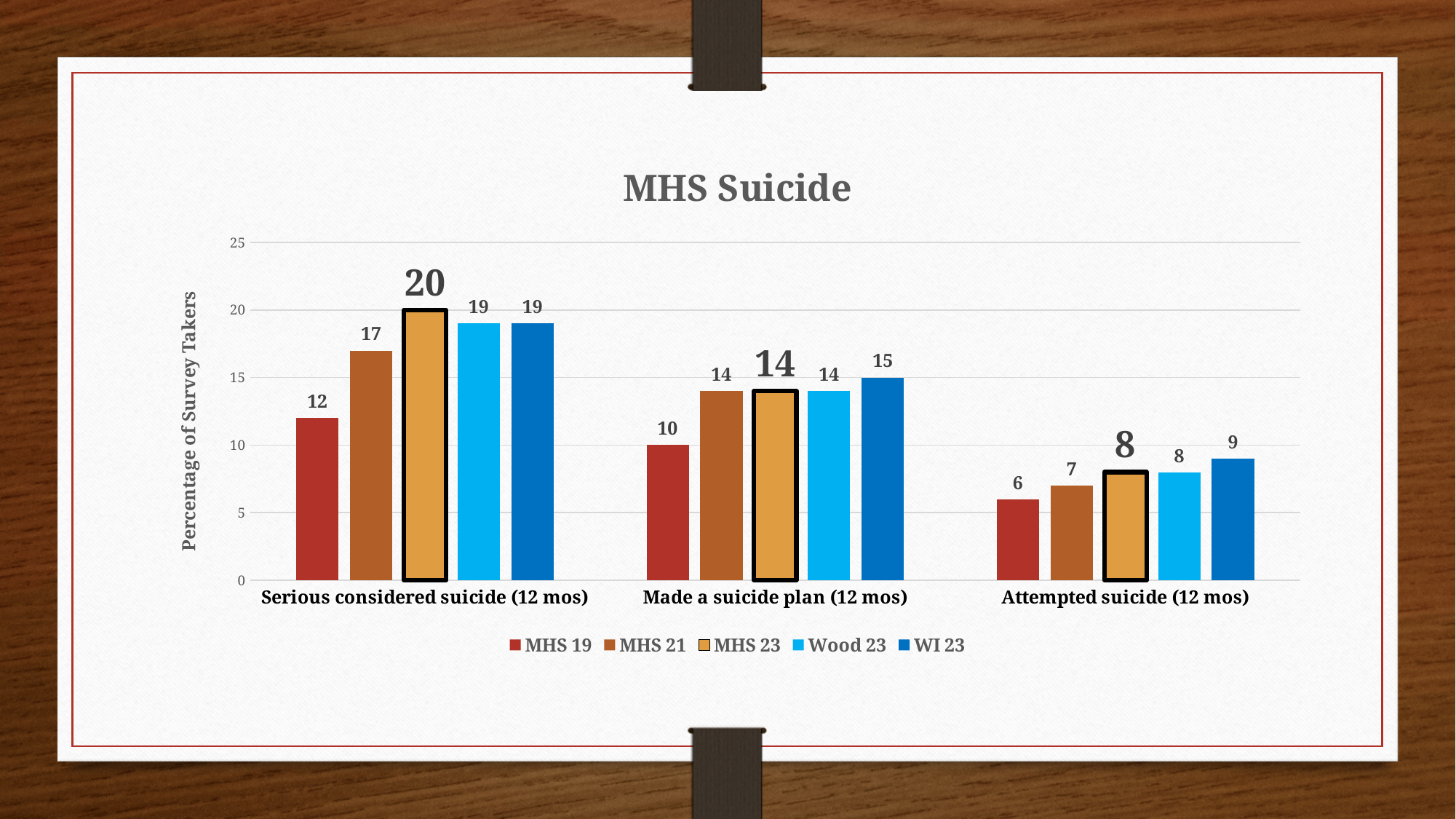
What kind of chart is shown on the slide? Bar chart What is the value for WI 23 in the 'Attempted suicide (12 mos)' category? 9 What is the value for MHS 23 in the 'Serious considered suicide (12 mos)' category? 20 How many categories are shown on the x axis? 3 How many series does the legend list? 5 What is the title of the chart? MHS Suicide What is the label of the vertical axis? Percentage of Survey Takers What is the difference between the MHS 23 and MHS 19 values in the 'Serious considered suicide (12 mos)' category? 8 What is the value for MHS 19 in the 'Made a suicide plan (12 mos)' category? 10 Which series has the lowest value in the 'Attempted suicide (12 mos)' category? MHS 19 Which series has the highest value in the 'Serious considered suicide (12 mos)' category? MHS 23 Which is larger in the 'Made a suicide plan (12 mos)' category: WI 23 or Wood 23? WI 23